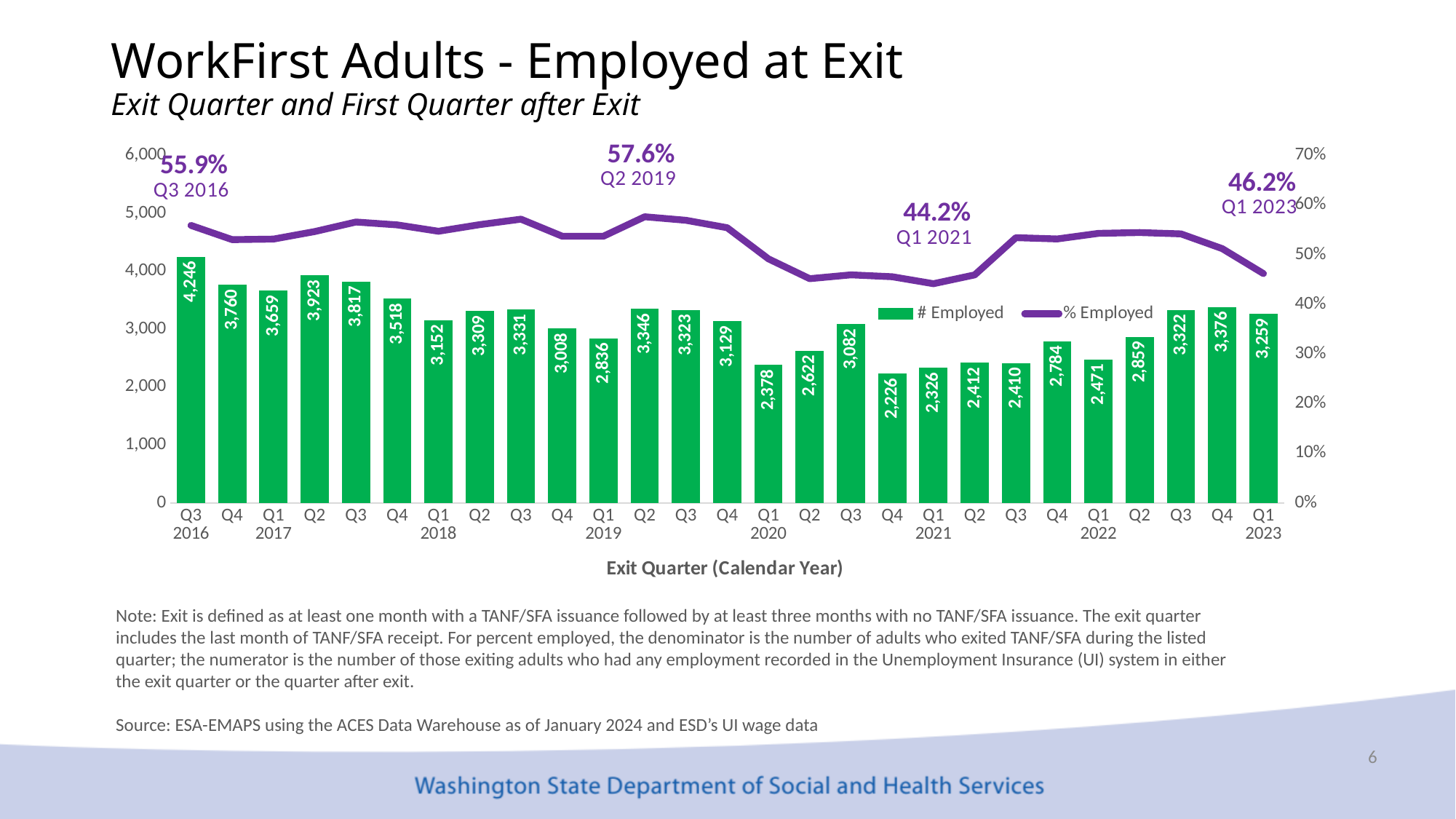
What is the difference in number employed between Q3 2016 and Q4 2020? 2,020 What percent employed is labelled for Q2 2019? 57.6% What is the number employed for Q3 2016? 4,246 What percent employed is labelled for Q1 2021? 44.2% Which exit quarter has the lowest number employed? Q4 2020 What is the number employed for Q1 2023? 3,259 Which has a larger number employed, Q4 2022 or Q1 2023? Q4 2022 How many series does the legend list? 2 Is the % Employed value for Q2 2020 greater or less than 50%? less Which exit quarter has the highest number employed? Q3 2016 How many exit quarters are shown on the x axis? 27 What is the x-axis title of the chart? Exit Quarter (Calendar Year)